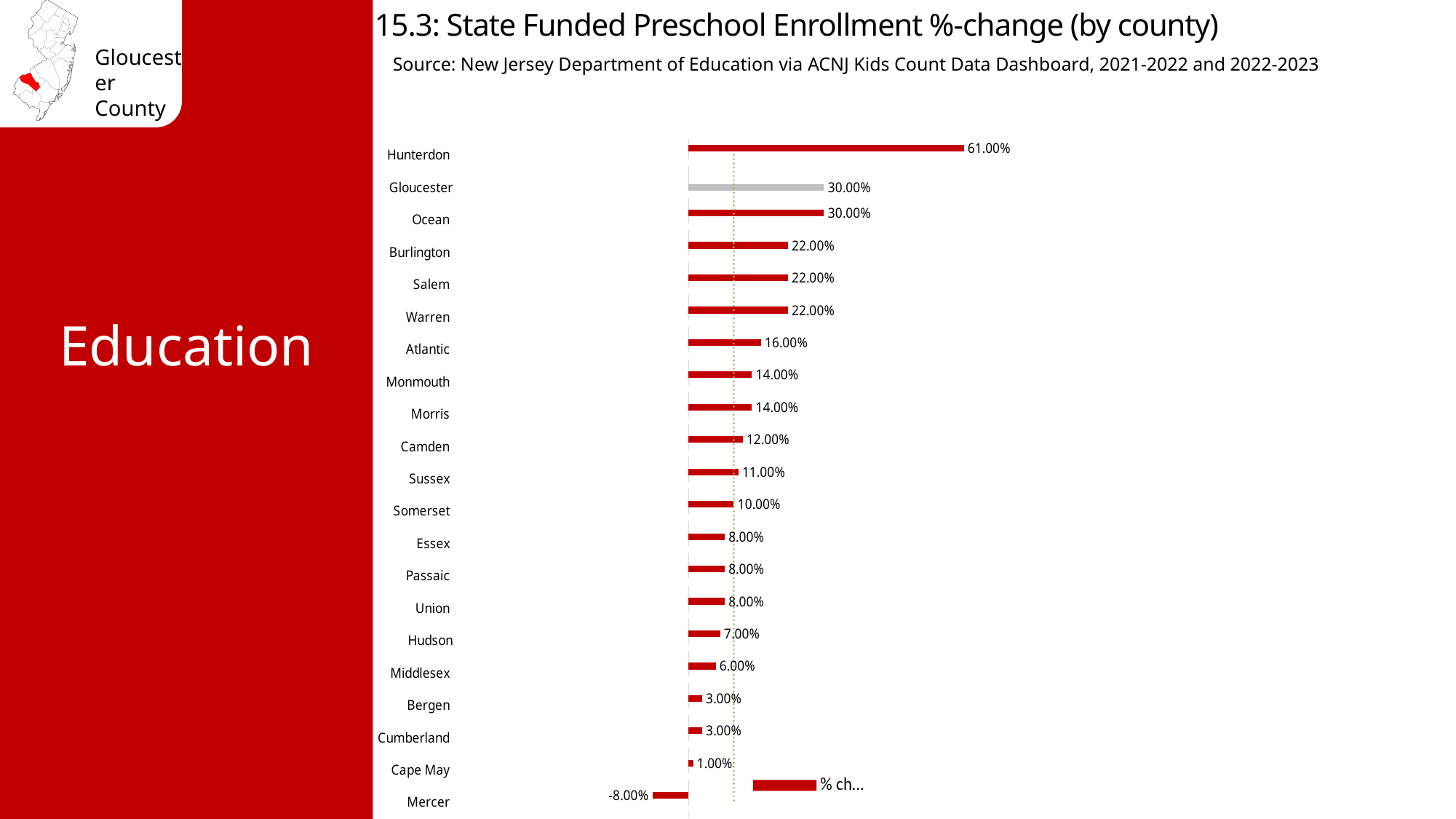
What is the difference between the values for Burlington and Camden? 10.00% What kind of chart is shown on the slide? Bar chart How many counties are shown in the chart? 21 Which county has the lowest %-change? Mercer Which county has the highest %-change? Hunterdon What is the state funded preschool enrollment %-change for Hunterdon? 61.00% Which is larger, the value for Somerset or the value for Middlesex? Somerset What is the value shown for Gloucester? 30.00% What is the value shown for Mercer? -8.00% Which county's bar is coloured grey instead of red? Gloucester What is the difference between the values for Hunterdon and Ocean? 31.00% What is the value shown for Atlantic? 16.00%